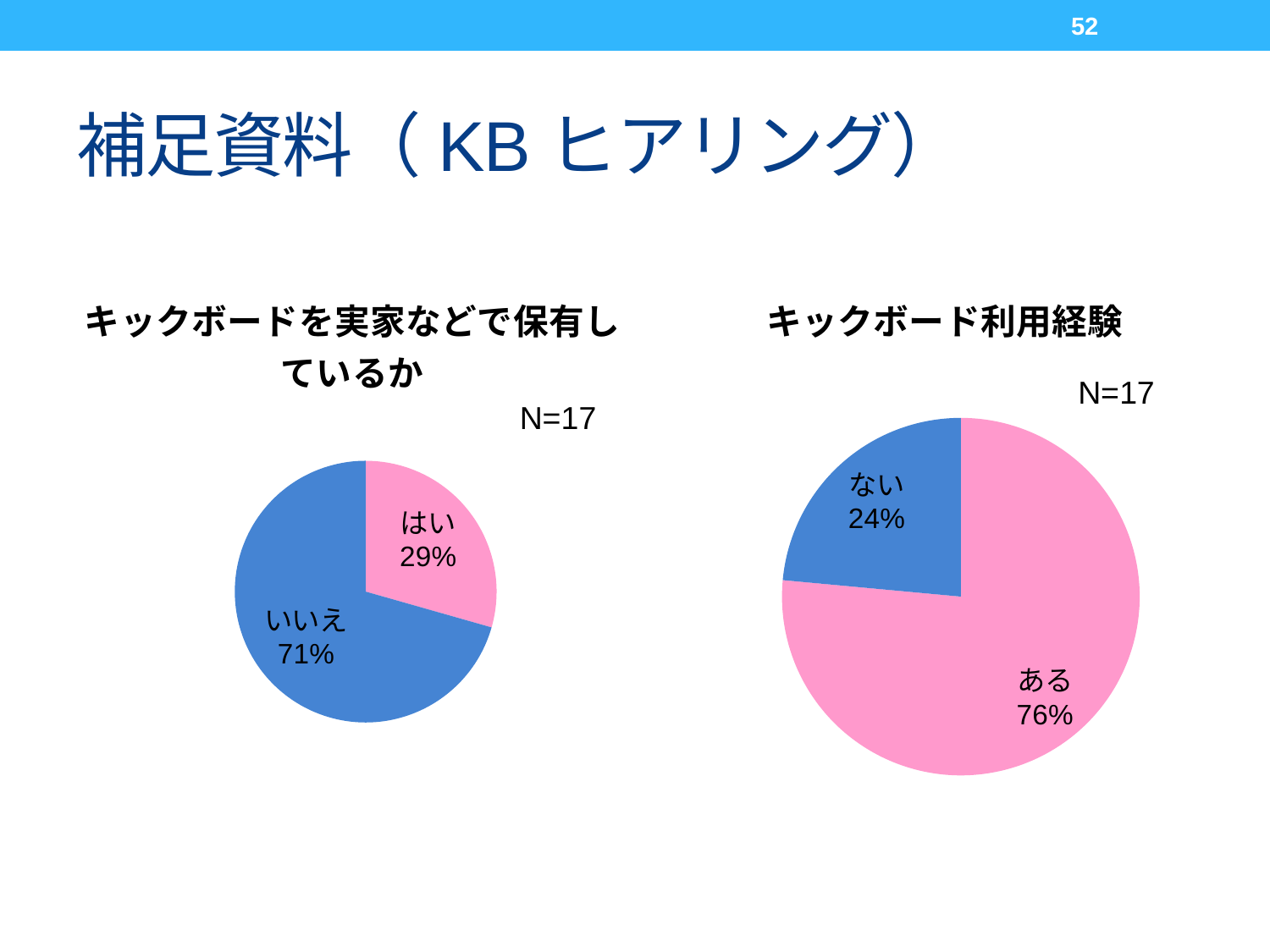
How many slices does the left chart (キックボードを実家などで保有しているか) have? 2 In the right chart (キックボード利用経験), what percentage is shown for ない? 24% In the left chart (キックボードを実家などで保有しているか), which slice is the largest? いいえ In the right chart (キックボード利用経験), which is larger, ある or ない? ある In the right chart (キックボード利用経験), what is the difference in percentage points between ある and ない? 52 In the right chart (キックボード利用経験), what percentage is shown for ある? 76% What sample size (N) is shown for the right chart (キックボード利用経験)? N=17 What type of chart is the right chart (キックボード利用経験)? Pie chart In the left chart (キックボードを実家などで保有しているか), what percentage is shown for はい? 29% In the left chart (キックボードを実家などで保有しているか), what is the difference in percentage points between いいえ and はい? 42 In the right chart (キックボード利用経験), which slice is the smallest? ない In the left chart (キックボードを実家などで保有しているか), what percentage is shown for いいえ? 71%